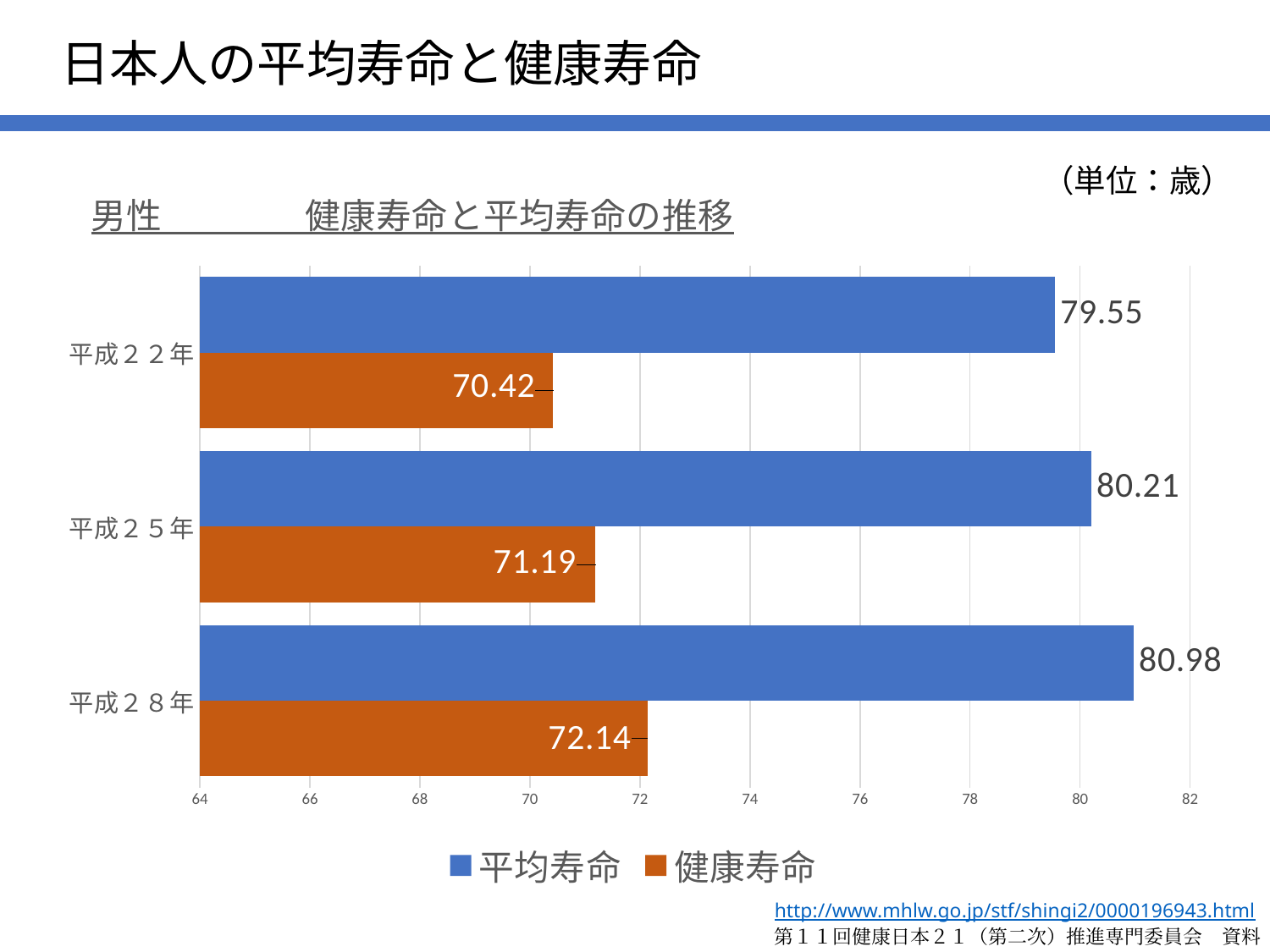
Which year has the lowest 健康寿命? 平成２２年 What is the 平均寿命 value for 平成２８年? 80.98 Is the 平均寿命 for 平成２２年 greater or less than 80? less What is the difference between 平均寿命 and 健康寿命 for 平成２８年? 8.84 How many years (categories) are shown in the chart? 3 What is the 健康寿命 value for 平成２２年? 70.42 What is the difference between the 平均寿命 for 平成２５年 and 平成２２年? 0.66 Does the 健康寿命 rise or fall from 平成２２年 to 平成２８年? rise Which year has the highest 平均寿命? 平成２８年 What is the 健康寿命 value for 平成２５年? 71.19 Which is larger, the 健康寿命 for 平成２８年 or the 健康寿命 for 平成２５年? 平成２８年 How many series does the legend list? 2